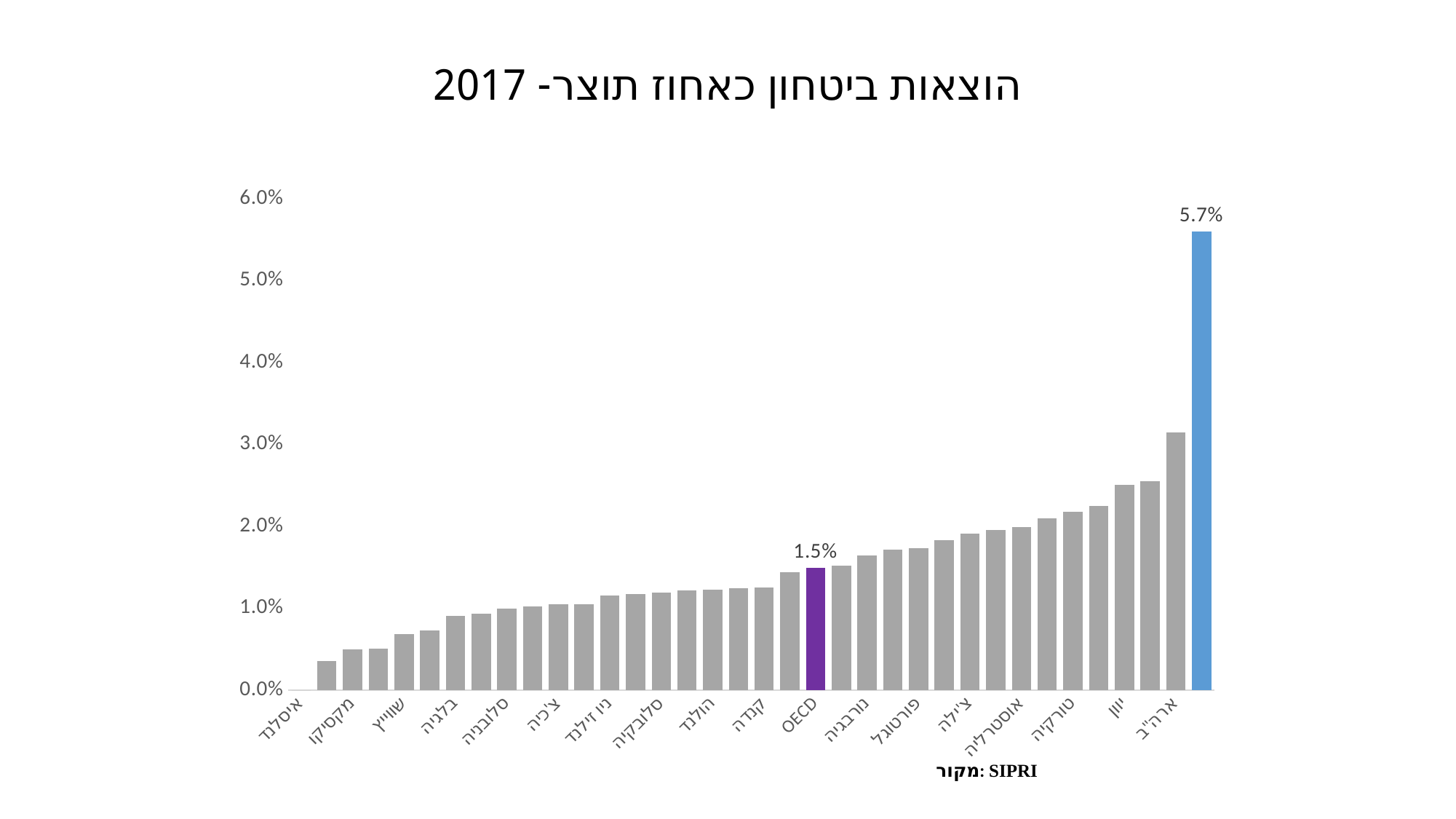
What kind of chart is shown on the slide? bar chart Do the values rise or fall from left to right along the x axis? rise What is the value shown for OECD? 1.5% Which category has the lowest value? איסלנד Is the value for איסלנד greater or less than 1.0%? less What source is cited for the chart data? SIPRI Which is larger, the value for יוון or the value for קנדה? יוון Which is larger, the value for ארה"ב or the value for OECD? ארה"ב Is the value for יוון greater or less than 2.0%? greater